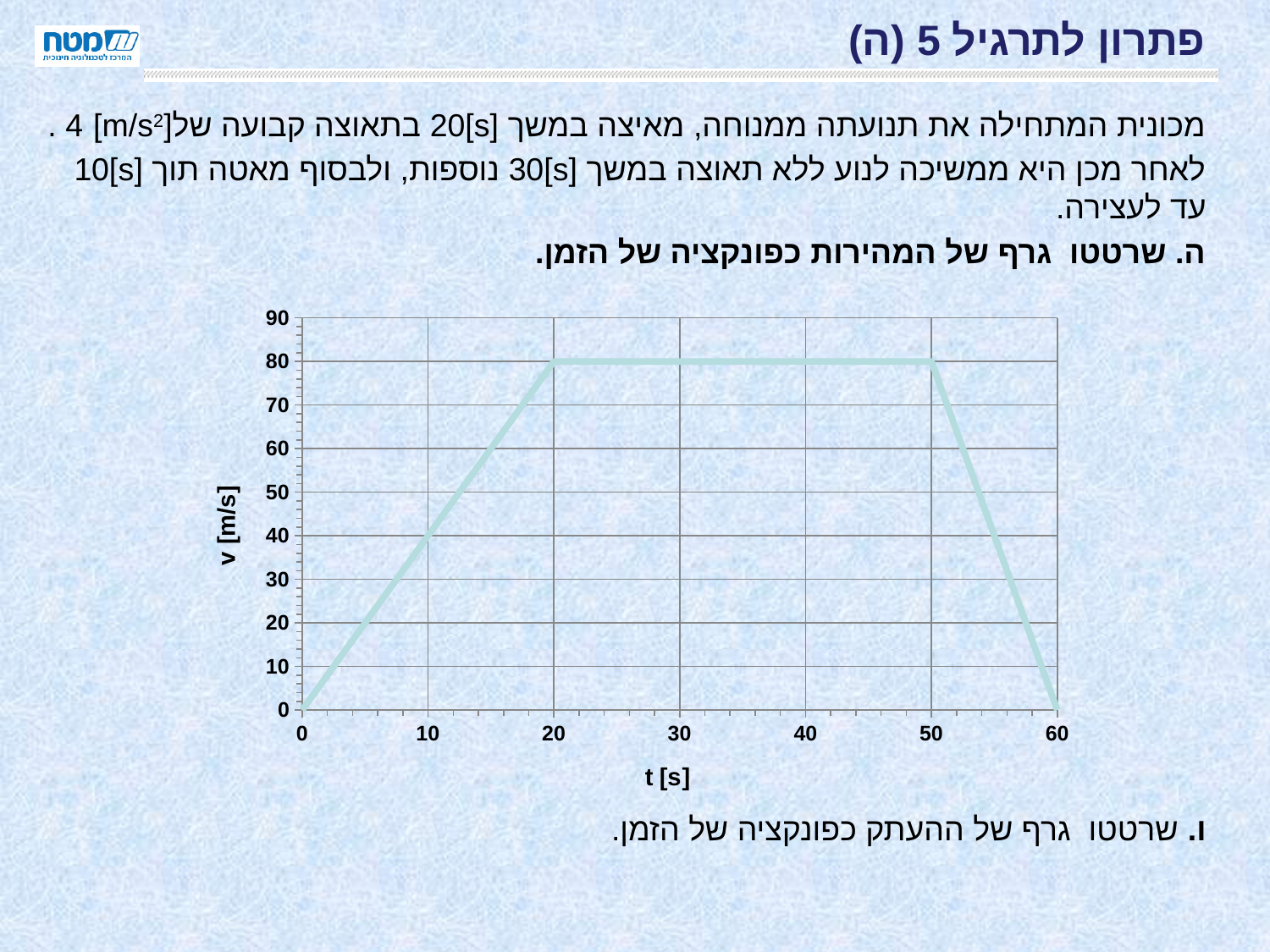
Is the value of v at t = 15 s greater or less than 50? greater What is the label of the x axis of the chart? t [s] Does v rise or fall between t = 0 s and t = 20 s? rise What kind of chart is shown on the slide? line chart Does v rise or fall between t = 50 s and t = 60 s? fall Is the value of v at t = 55 s greater or less than 60? less What is the value of v at t = 20 s? 80 What is the value of v at t = 60 s? 0 What is the value of v at t = 0 s? 0 What is the value of v at t = 50 s? 80 What is the value of v at t = 10 s? 40 What is the label of the y axis of the chart? v [m/s]